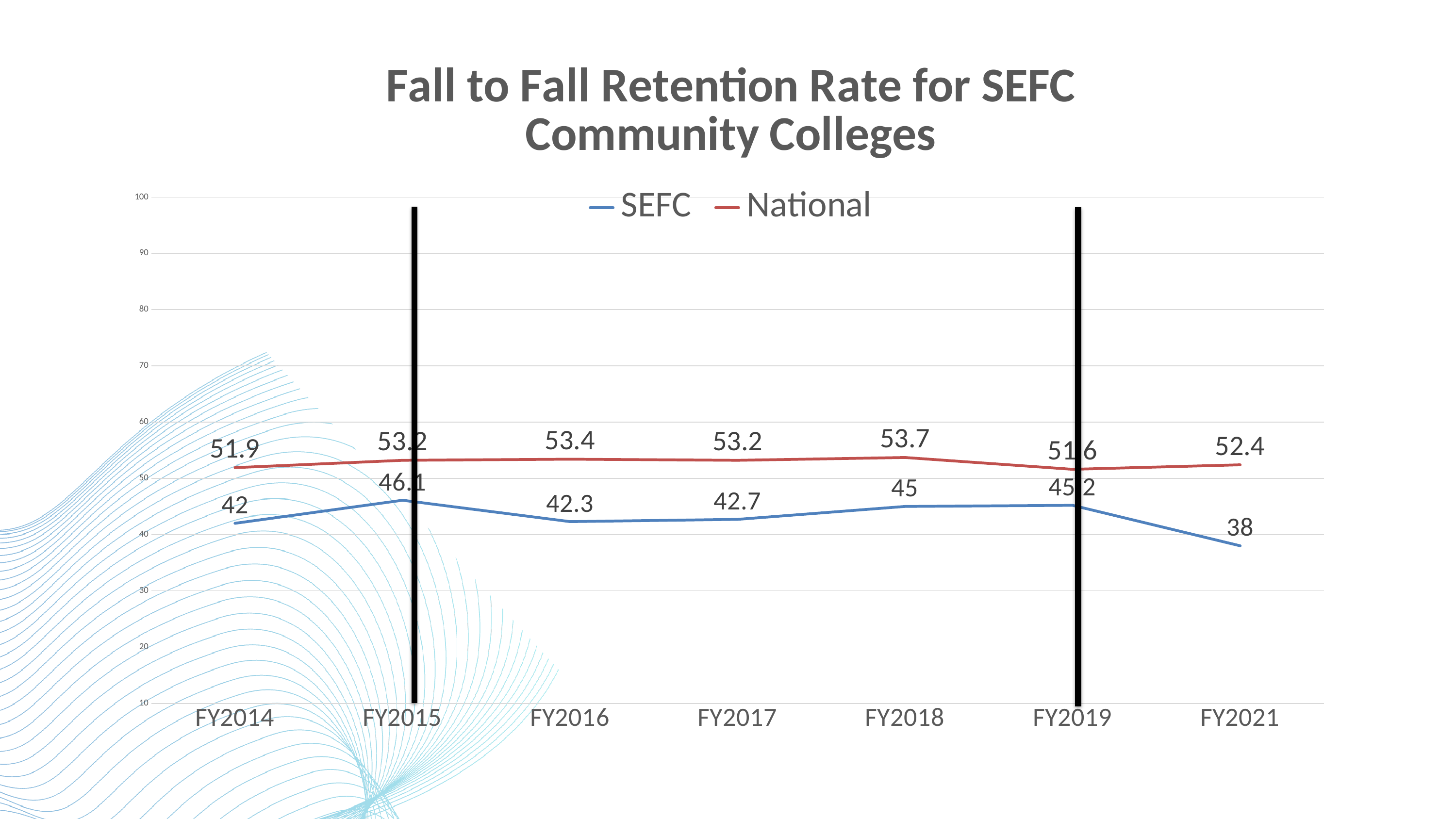
What is the difference between the National and SEFC retention rates in FY2021? 14.4 In which fiscal year is the SEFC retention rate lowest? FY2021 In which fiscal year is the National retention rate highest? FY2018 What kind of chart is shown on the slide? line chart How many series does the legend list? 2 How many fiscal years are plotted along the x axis? 7 What is the National retention rate for FY2018? 53.7 Is the SEFC value for FY2018 greater or less than 50? less What is the SEFC retention rate for FY2021? 38 In which fiscal year is the SEFC retention rate highest? FY2015 What is the SEFC retention rate for FY2014? 42 Which is larger, the SEFC retention rate in FY2016 or in FY2017? FY2017